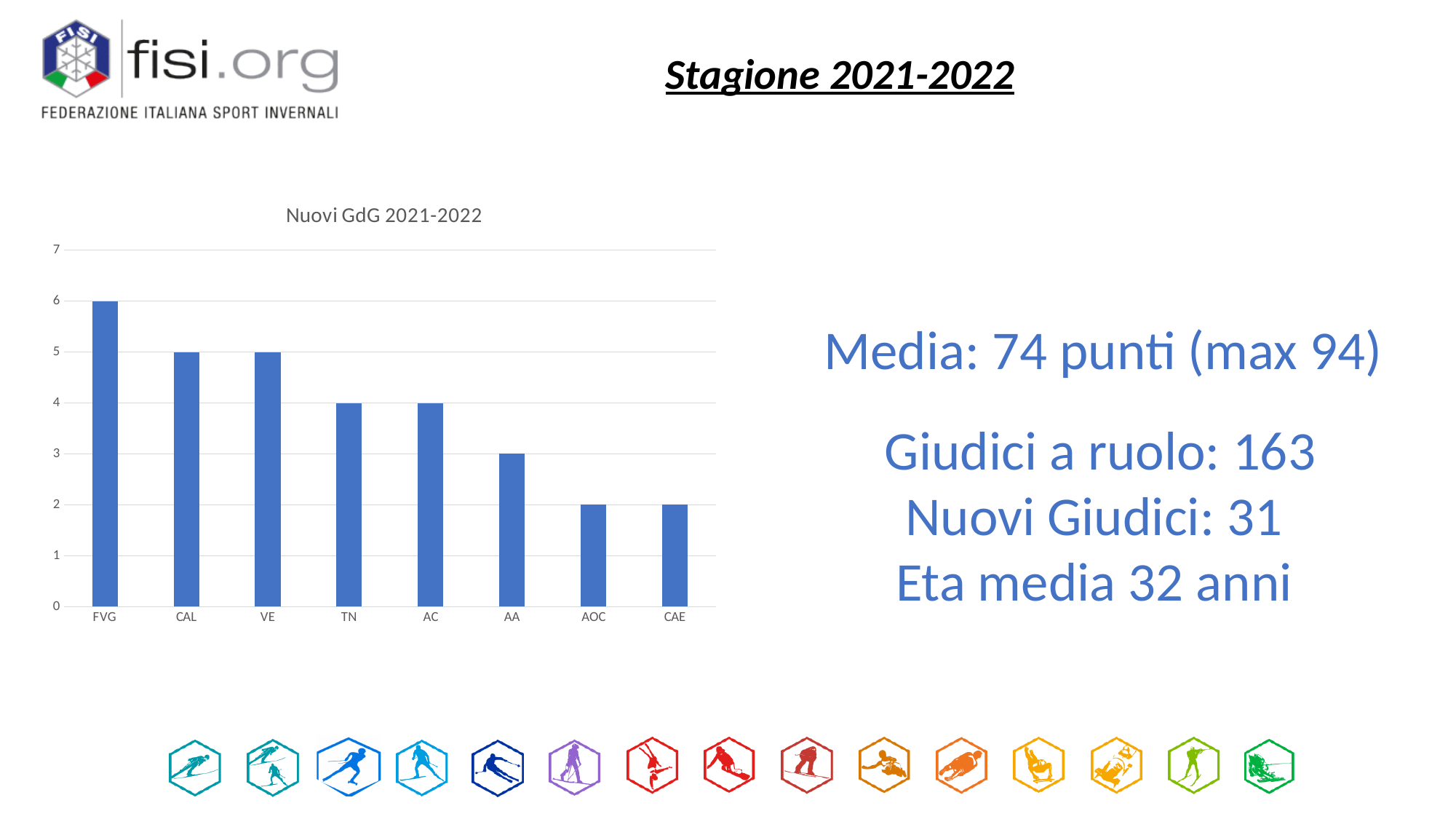
Which is larger, the value for CAL or the value for AA? CAL What is the value for AA? 3 What is the value for FVG? 6 What is the value for CAE? 2 What is the difference between the values for FVG and AOC? 4 What is the difference between the values for VE and TN? 1 Which category has the highest value? FVG Do the values rise or fall from left to right along the x axis? fall What kind of chart is shown on the slide? bar chart What is the title of the chart? Nuovi GdG 2021-2022 How many categories are shown on the x axis of the chart? 8 What is the value for TN? 4